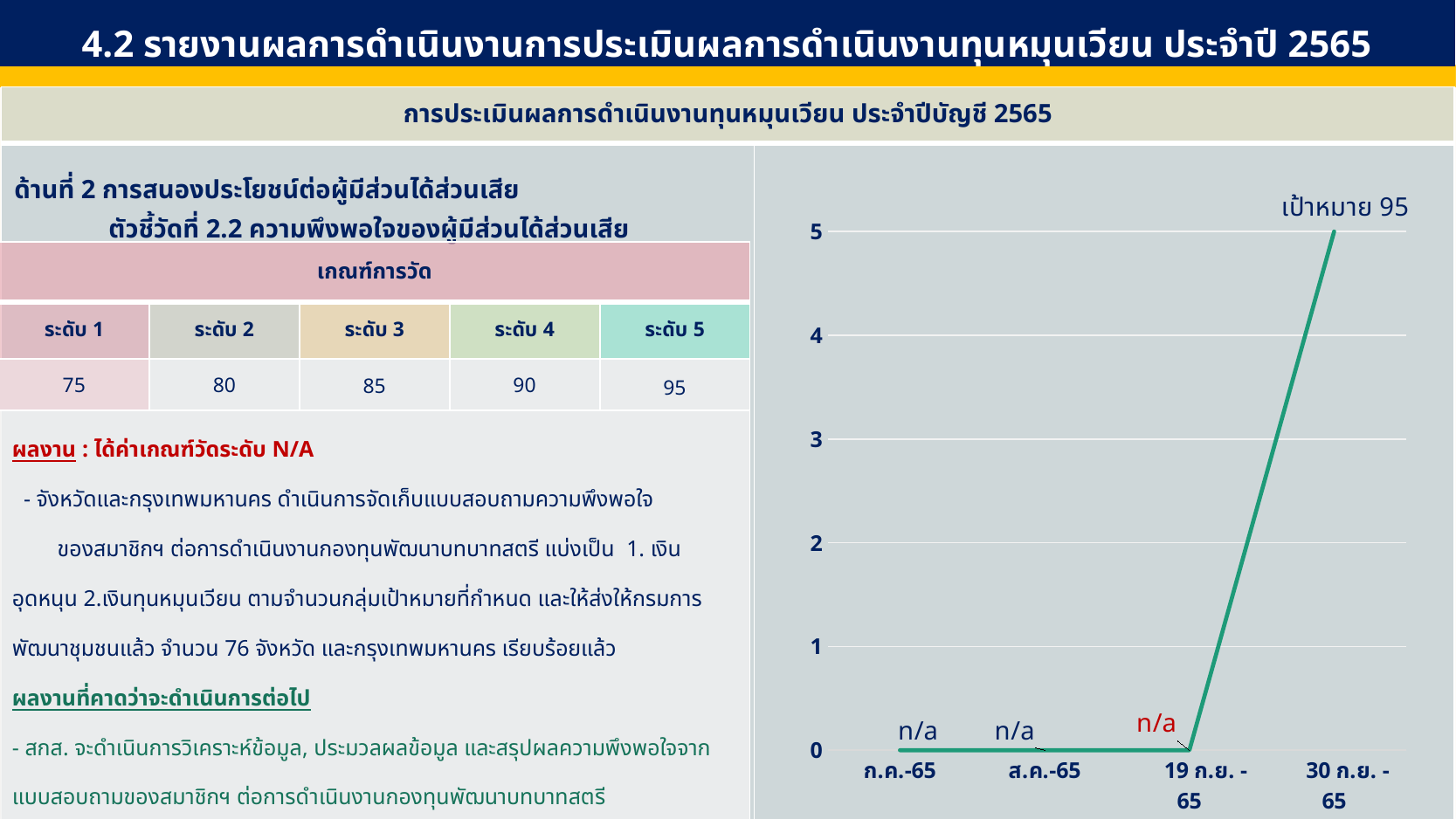
Is the value for 30 ก.ย.-65 greater or less than 4? greater Is the value for 19 ก.ย.-65 greater or less than 1? less What text label is shown next to the top of the line in the chart? เป้าหมาย 95 Which category has the highest value in the line chart? 30 ก.ย.-65 What value does the line reach at 30 ก.ย.-65 in the line chart? 5 Does the line rise or fall between 19 ก.ย.-65 and 30 ก.ย.-65? rise What is the data label shown for 19 ก.ย.-65 in the line chart? n/a How many categories are shown on the x axis of the line chart? 4 Which is larger in the line chart, the value for ส.ค.-65 or the value for 30 ก.ย.-65? 30 ก.ย.-65 What kind of chart is shown on the right side of the slide? line chart What is the data label shown for ก.ค.-65 in the line chart? n/a What is the data label shown for ส.ค.-65 in the line chart? n/a